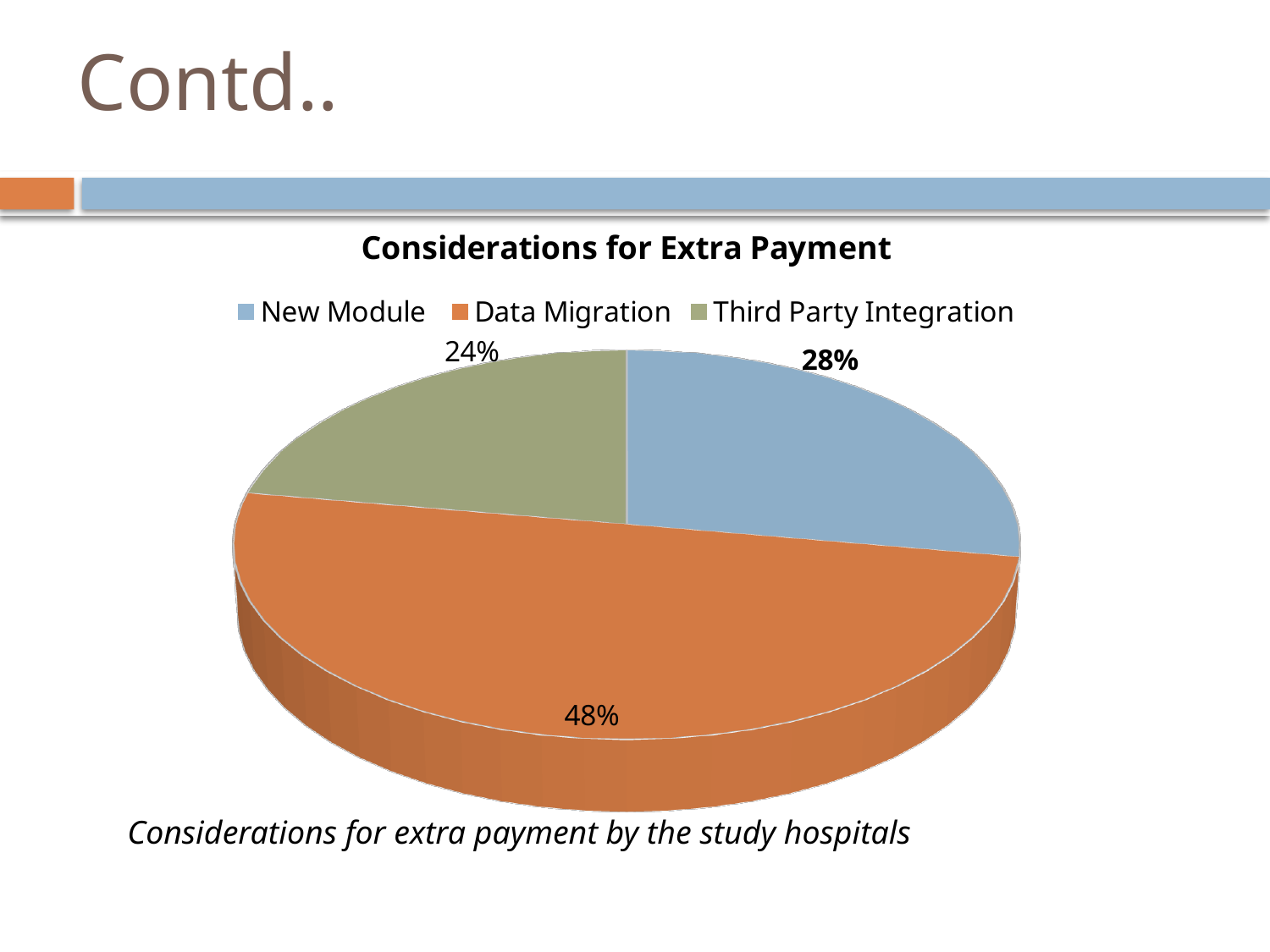
What is the difference in percentage points between New Module and Third Party Integration? 4 Which colour represents Data Migration in the legend? Orange Which category has the smallest share of the pie? Third Party Integration What kind of chart is shown on the slide? Pie chart What percentage of the pie is Third Party Integration? 24% How many categories are shown in the pie chart? 3 What percentage of the pie is New Module? 28% What percentage of the pie is Data Migration? 48% What is the difference in percentage points between Data Migration and New Module? 20 What is the title of the chart? Considerations for Extra Payment Which is larger, the share for New Module or the share for Third Party Integration? New Module Which category has the largest share of the pie? Data Migration